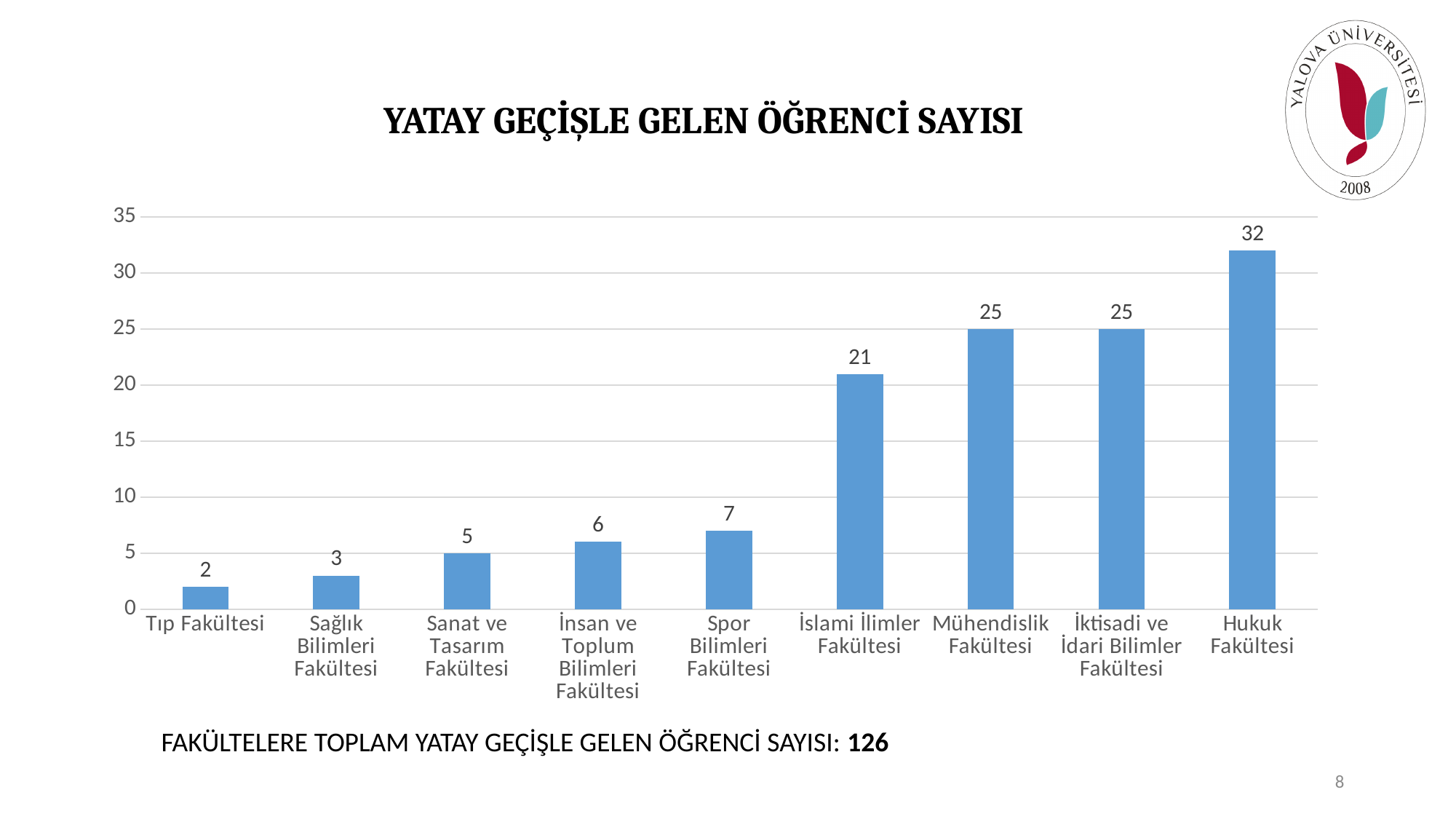
What is the title of the chart? YATAY GEÇİŞLE GELEN ÖĞRENCİ SAYISI Which faculty has the lowest number of students? Tıp Fakültesi What is the value for Spor Bilimleri Fakültesi? 7 What is the value for Hukuk Fakültesi? 32 What is the difference between the values for İslami İlimler Fakültesi and Spor Bilimleri Fakültesi? 14 Which faculty has the highest number of students? Hukuk Fakültesi Which is larger, the value for Sağlık Bilimleri Fakültesi or the value for Sanat ve Tasarım Fakültesi? Sanat ve Tasarım Fakültesi What kind of chart is shown on the slide? bar chart What is the value for İslami İlimler Fakültesi? 21 What is the difference between the values for Hukuk Fakültesi and Mühendislik Fakültesi? 7 How many faculties are shown on the chart? 9 Is the value for İktisadi ve İdari Bilimler Fakültesi greater or less than 20? greater